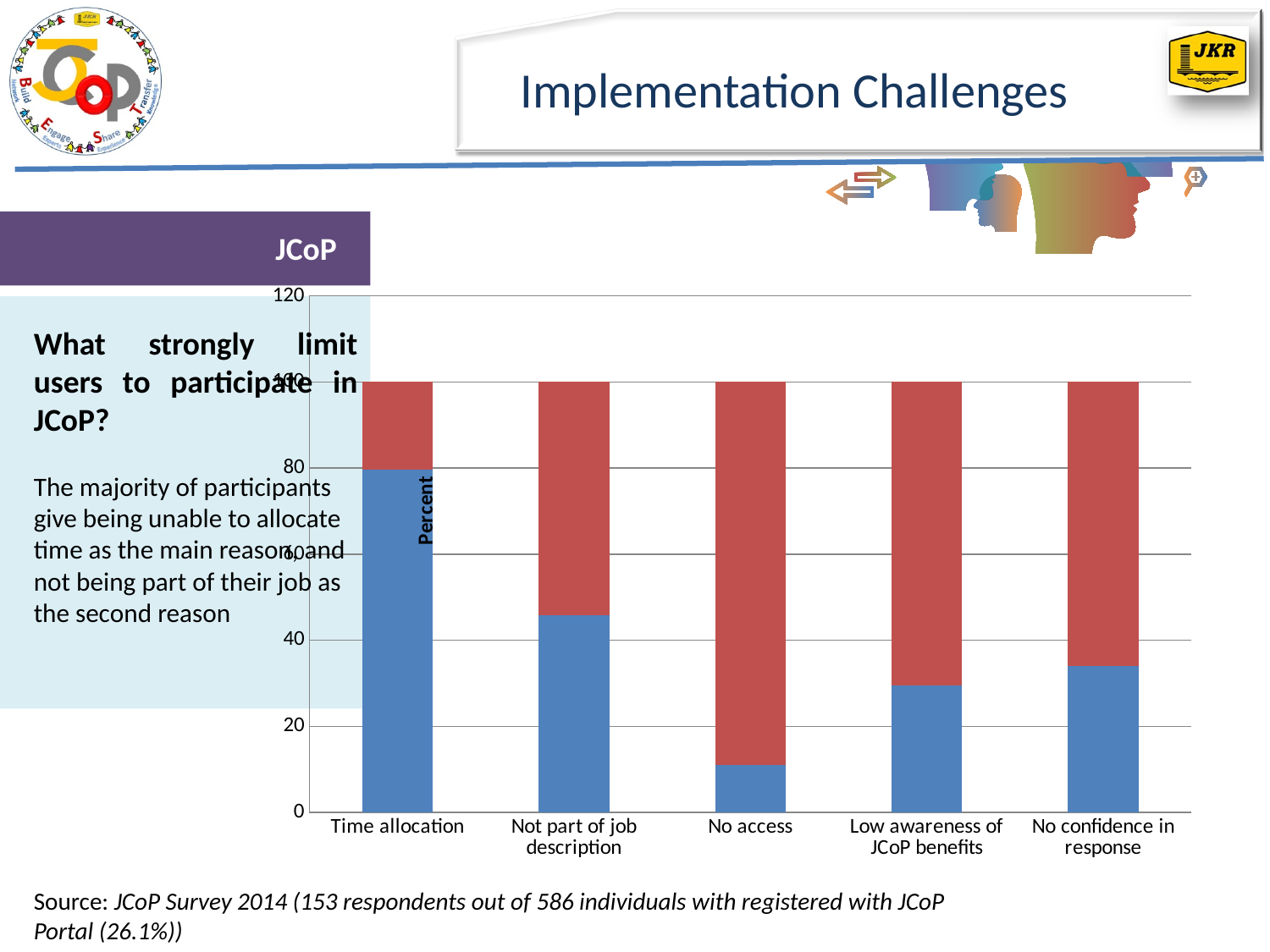
What is the label on the vertical axis of the chart? Percent What kind of chart is shown on the slide? stacked bar chart What is the highest value shown on the vertical axis of the chart? 120 Which category has the shortest blue segment? No access Is the blue segment for Not part of job description greater or less than 40? greater Is the blue segment for Low awareness of JCoP benefits greater or less than 40? less Which category has the tallest blue segment? Time allocation Is the blue segment for No access greater or less than 20? less Which has a larger blue segment: Not part of job description or No confidence in response? Not part of job description How many categories are shown on the x axis of the chart? 5 Which has a larger blue segment: No access or Low awareness of JCoP benefits? Low awareness of JCoP benefits